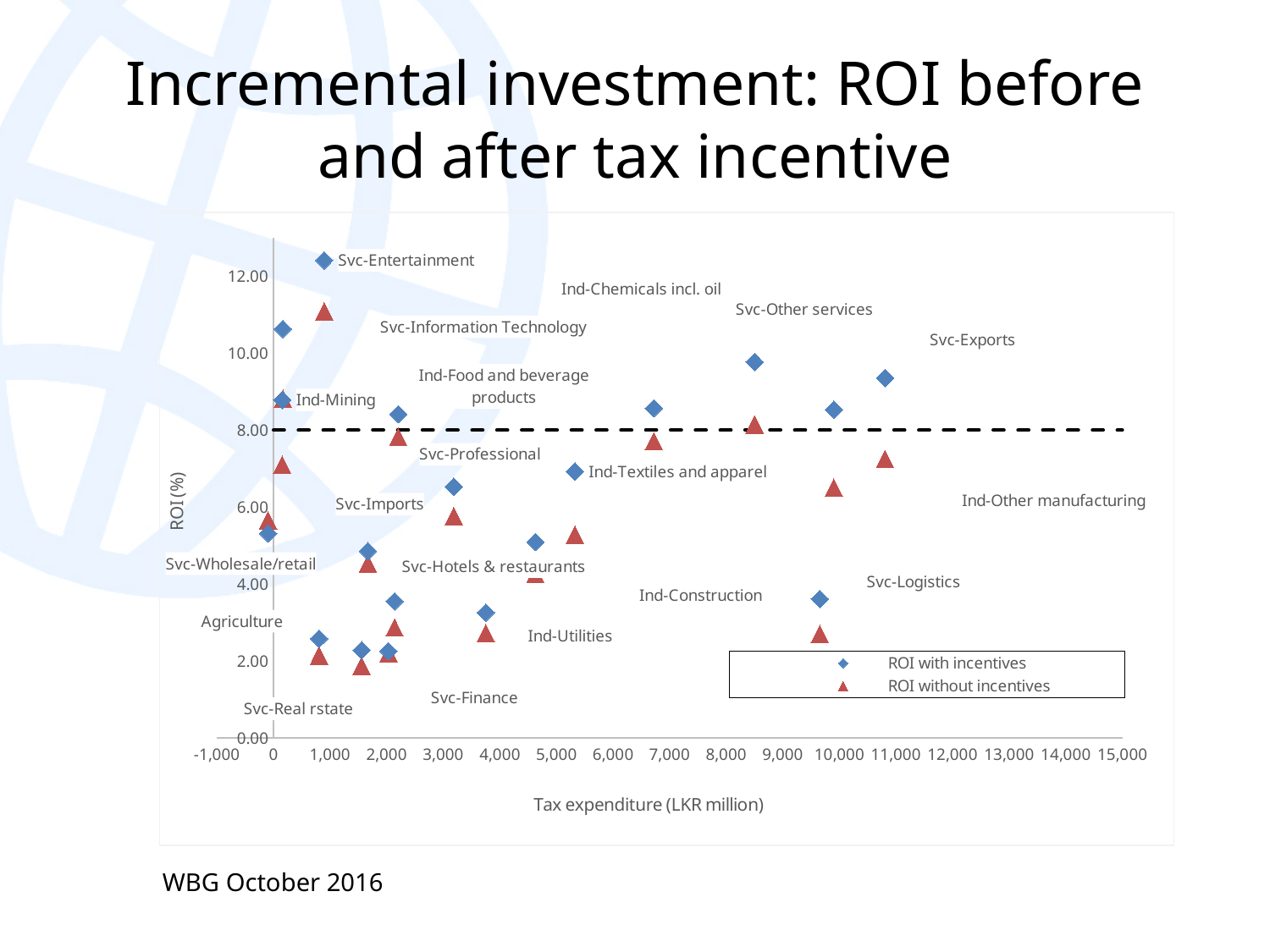
How many series does the legend list? 2 Is the tax expenditure for Svc-Exports greater or less than 10,000 LKR million? greater Is the ROI with incentives for Ind-Textiles and apparel greater or less than 8.00? less Which has the higher ROI with incentives, Svc-Entertainment or Svc-Logistics? Svc-Entertainment What is the title of the x axis? Tax expenditure (LKR million) Is the ROI with incentives for Svc-Logistics greater or less than 4.00? less What are the two series named in the legend? ROI with incentives; ROI without incentives What kind of chart is shown on the slide? Scatter chart